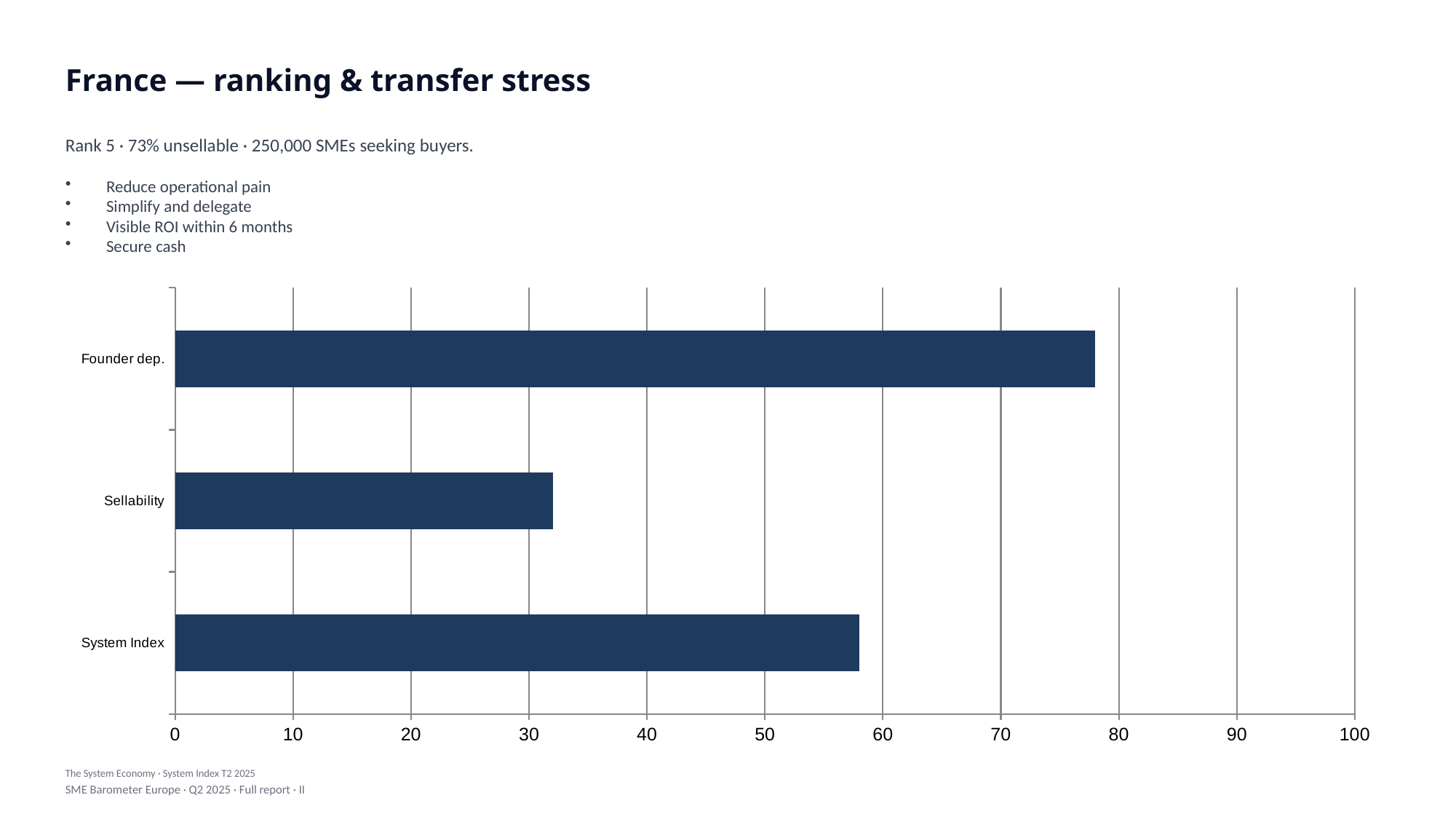
Which category is listed at the top of the bar chart? Founder dep. Which is larger, the value for Founder dep. or the value for System Index? Founder dep. Is the value for System Index greater or less than 50? greater Which category has the lowest value in the bar chart? Sellability Is the value for Founder dep. greater or less than 70? greater How many categories does the bar chart show? 3 What is the maximum value shown on the horizontal axis of the bar chart? 100 Which is larger, the value for Sellability or the value for System Index? System Index What kind of chart is shown on the slide? bar chart Is the value for Sellability greater or less than 40? less Which category has the highest value in the bar chart? Founder dep.